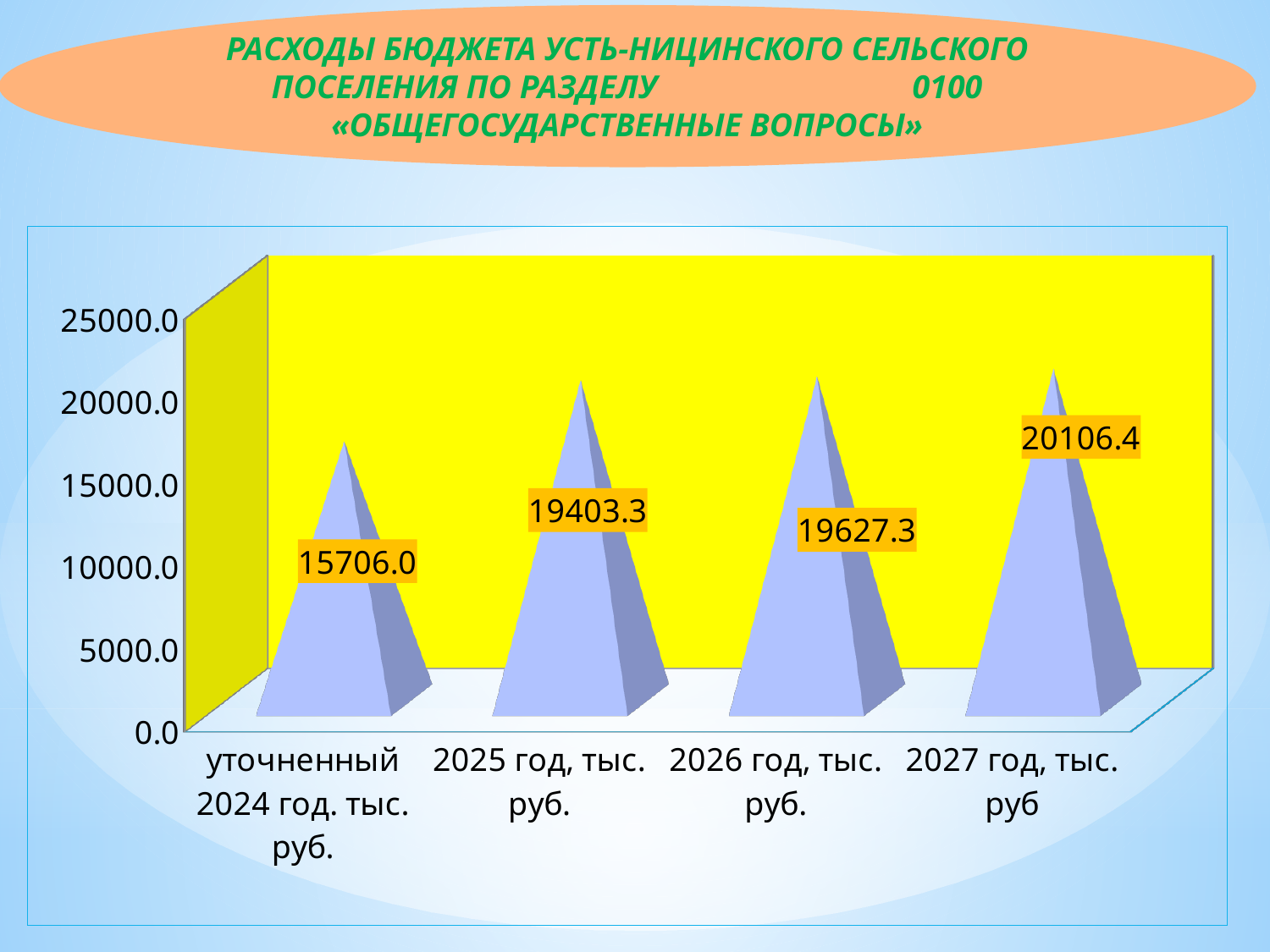
Which category has the lowest value? уточненный 2024 год. тыс. руб. Do the values rise or fall from 2024 to 2027 along the x axis? rise Which category has the highest value? 2027 год, тыс. руб Which is larger, the value for 2026 год or the value for 2025 год? 2026 год, тыс. руб. What is the difference between the values for 2026 год and 2025 год? 224.0 What kind of chart is shown on the slide? bar chart How many categories are shown on the chart? 4 Is the value for уточненный 2024 год greater or less than 20000.0? less What is the difference between the values for 2027 год and уточненный 2024 год? 4400.4 What is the value for 2027 год, тыс. руб? 20106.4 What is the value for 2025 год, тыс. руб.? 19403.3 What is the value for уточненный 2024 год. тыс. руб.? 15706.0